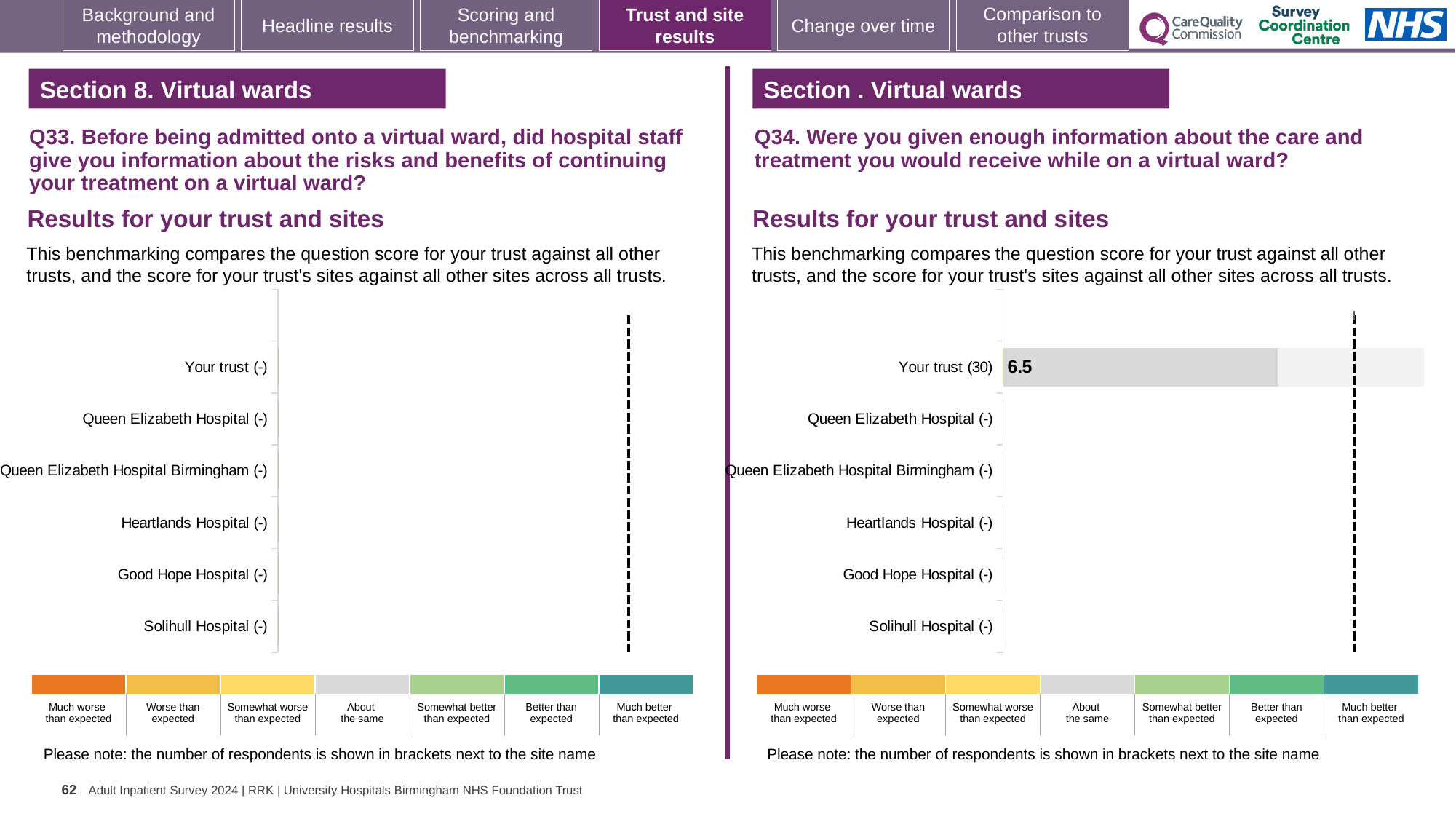
In the Q34 chart on the right, which category is the only one with a plotted bar? Your trust (30) How many benchmark bands does the colour key below the Q34 chart on the right show? 7 In the Q34 chart on the right, is the value for Your trust greater or less than 5? greater In the Q34 chart on the right, how many respondents are shown in brackets next to Your trust? 30 In the Q34 chart on the right, what is the score shown for Your trust? 6.5 How many categories are listed on the vertical axis of the Q34 chart on the right? 6 In the Q33 chart on the left, how many bars are plotted? 0 How many categories are listed on the vertical axis of the Q33 chart on the left? 6 What kind of chart is the Q34 chart on the right? Bar chart